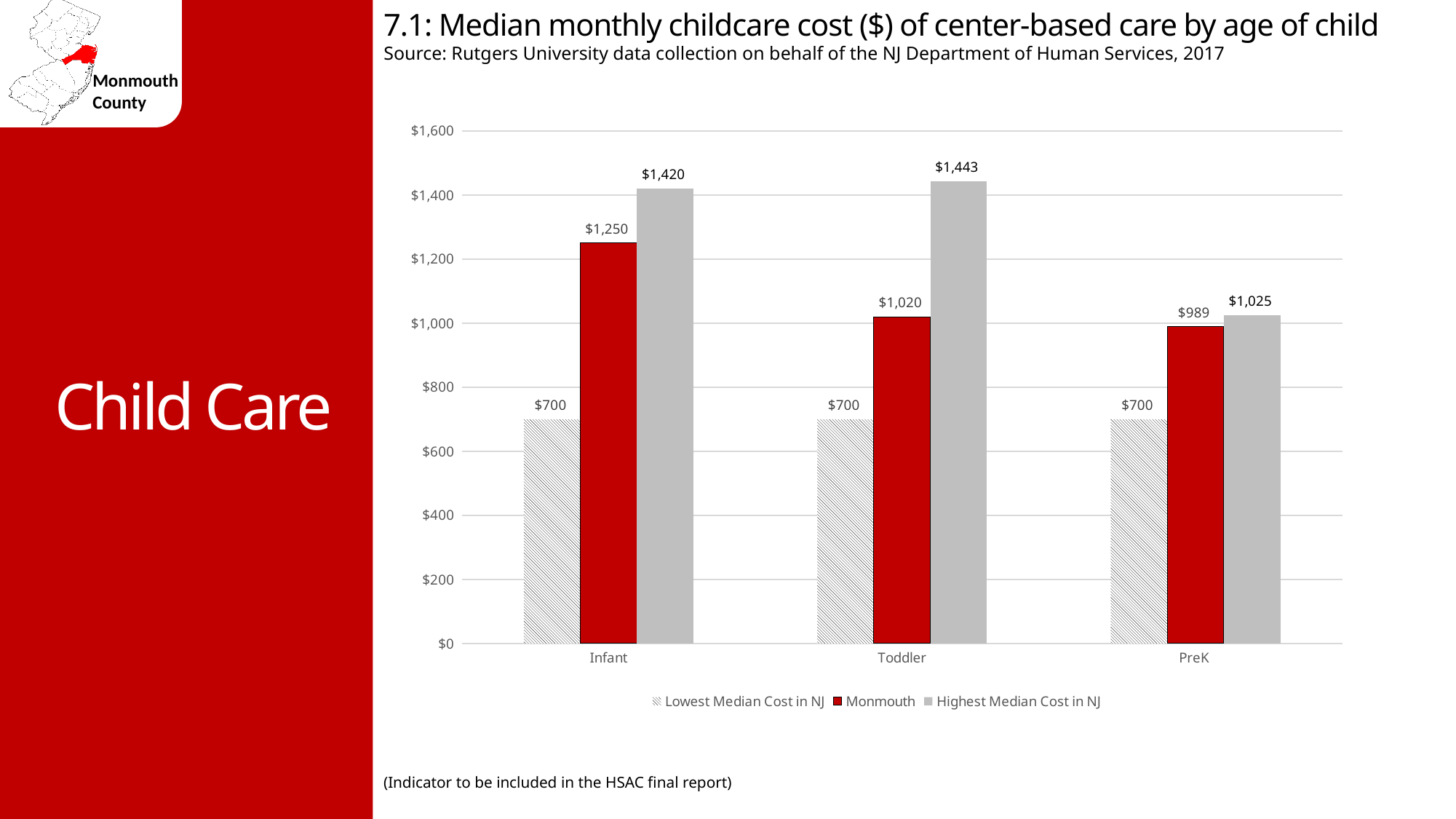
How many age groups are shown on the x axis? 3 Which is larger for Toddler care: the Monmouth cost or the Highest Median Cost in NJ? Highest Median Cost in NJ What is the Monmouth median monthly cost for PreK care? $989 What is the Highest Median Cost in NJ for Toddler care? $1,443 For which age group is the Monmouth median monthly cost highest? Infant What is the difference between the Monmouth cost and the Lowest Median Cost in NJ for Toddler care? $320 What is the Lowest Median Cost in NJ for PreK care? $700 What is the Monmouth median monthly childcare cost for Infant care? $1,250 How many series does the legend list? 3 For which age group is the Monmouth median monthly cost lowest? PreK What is the difference between the Highest Median Cost in NJ and the Monmouth cost for Infant care? $170 What kind of chart is shown on the slide? Bar chart